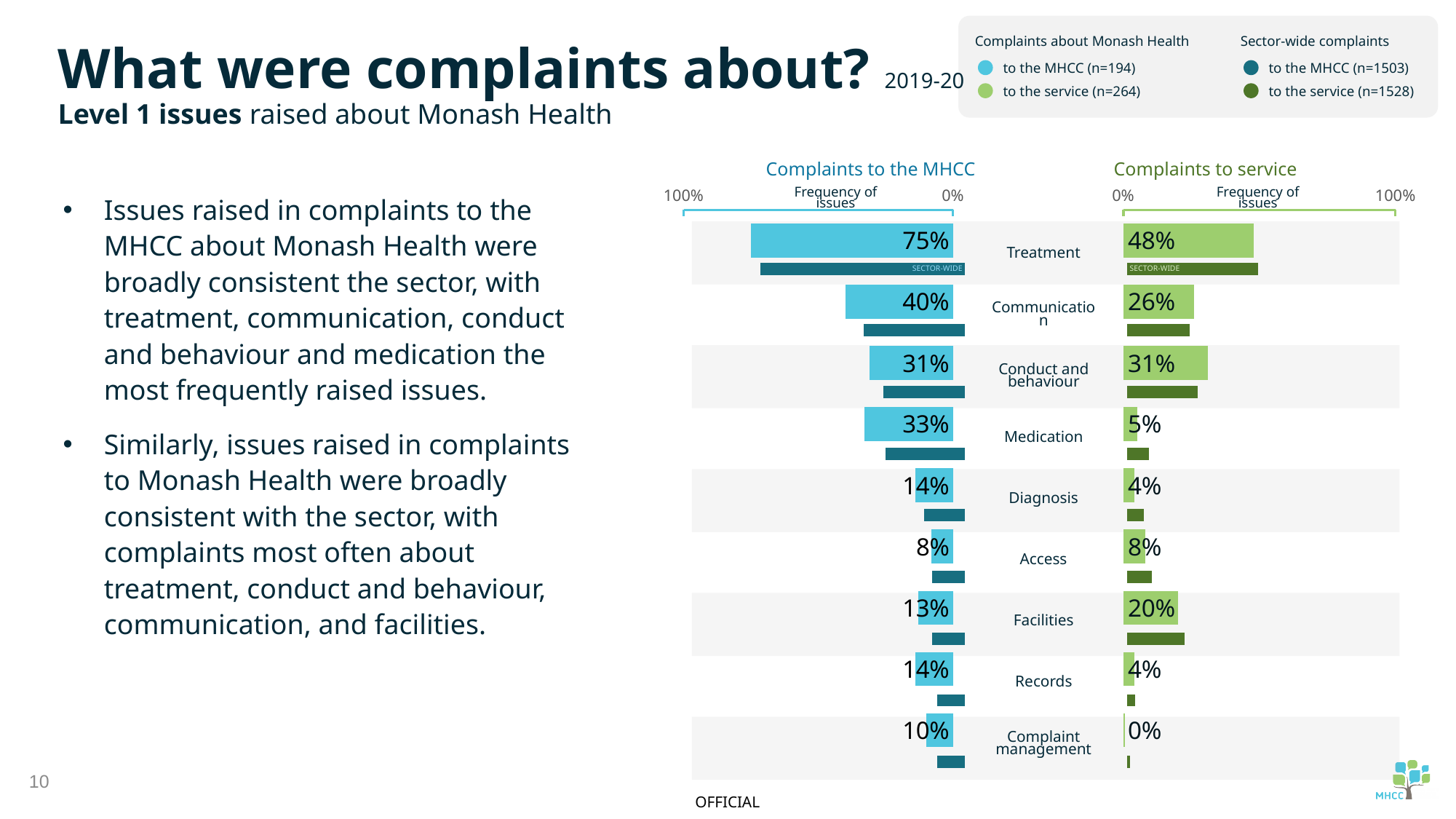
In the 'Complaints to service' chart, what percentage of issues were about Facilities? 20% In the 'Complaints to service' chart, which category has the lowest frequency of issues? Complaint management In the 'Complaints to the MHCC' chart, what is the difference between the Treatment value and the Communication value? 35% In the 'Complaints to service' chart, what is the value for Medication? 5% In the 'Complaints to the MHCC' chart, what percentage of issues were about Treatment? 75% What type of chart is the 'Complaints to service' chart? Bar chart In the 'Complaints to the MHCC' chart, what is the value for Medication? 33% According to the legend, how many complaints about Monash Health were made to the MHCC (n)? 194 In the 'Complaints to the MHCC' chart, what is the difference between the Medication value and the Diagnosis value? 19% In the 'Complaints to the MHCC' chart, which category has the highest frequency of issues? Treatment In the 'Complaints to service' chart, which is larger: the value for Communication or the value for Conduct and behaviour? Conduct and behaviour How many categories of issues are listed in the 'Complaints to the MHCC' chart? 9